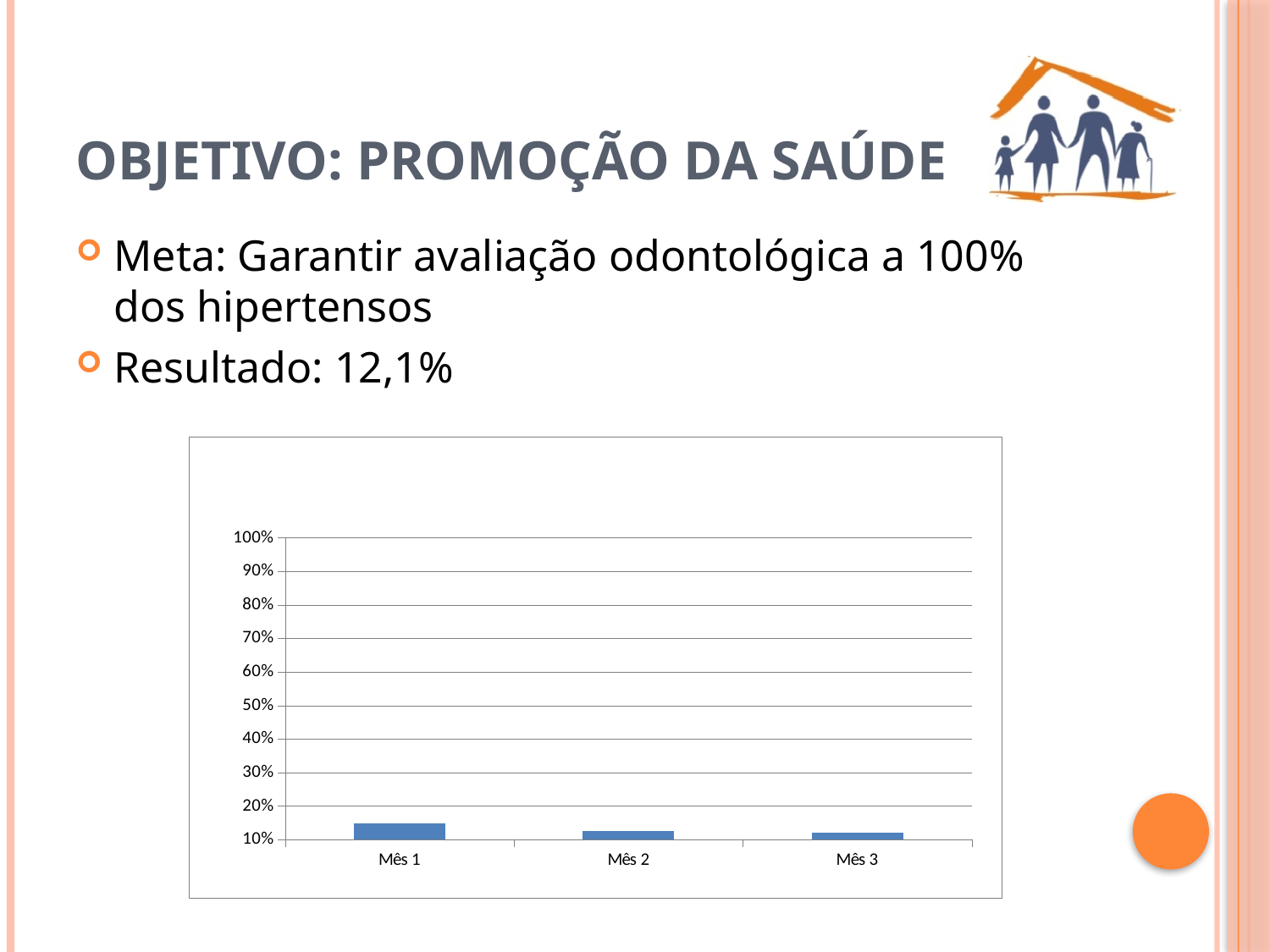
What is the lowest value shown on the y axis of the chart? 10% Is the value for Mês 1 greater or less than 20%? less Which month has the highest bar in the chart? Mês 1 Is the value for Mês 1 greater or less than 10%? greater Is the value for Mês 2 greater or less than 20%? less How many categories are shown on the x axis of the chart? 3 What kind of chart is shown on the slide? bar chart Which is larger, the value for Mês 1 or the value for Mês 2? Mês 1 Do the values rise or fall from Mês 1 to Mês 3? fall Which is larger, the value for Mês 1 or the value for Mês 3? Mês 1 What is the highest value shown on the y axis of the chart? 100%